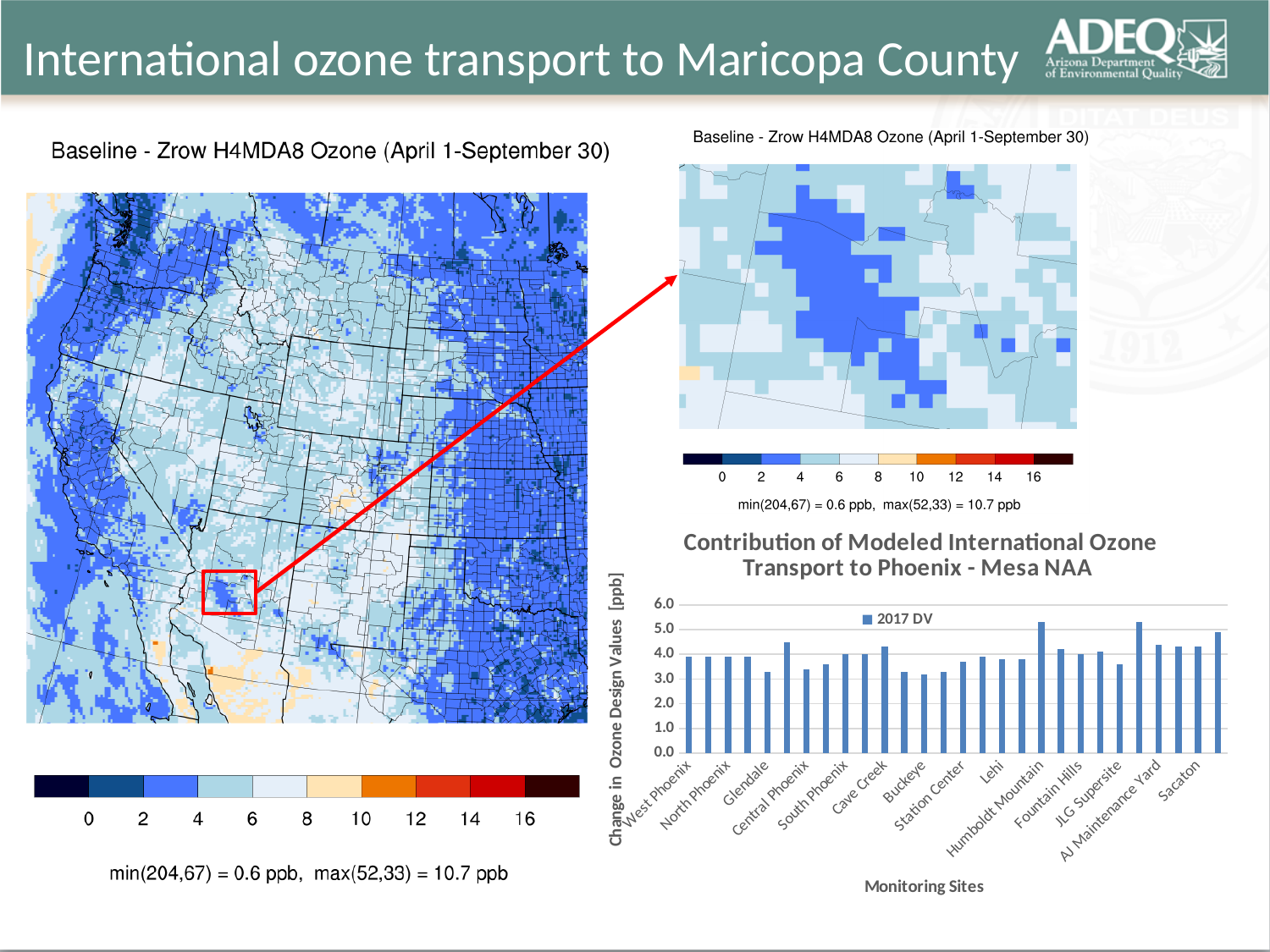
What is the name of the series shown in the legend of the bar chart? 2017 DV According to the text under the left map, what is the maximum value shown? 10.7 ppb What kind of chart is 'Contribution of Modeled International Ozone Transport to Phoenix - Mesa NAA'? bar chart How many series does the legend of the 'Contribution of Modeled International Ozone Transport to Phoenix - Mesa NAA' chart list? 1 In the bar chart, do any bars exceed 6.0 on the y-axis? No What is the y-axis title of the bar chart? Change in Ozone Design Values [ppb] In the bar chart, is the value for West Phoenix greater or less than 5.0? less In the bar chart, is the value for West Phoenix greater or less than 3.0? greater What is the highest value shown on the y-axis of the bar chart? 6.0 According to the text under the left map, what is the minimum value shown? 0.6 ppb